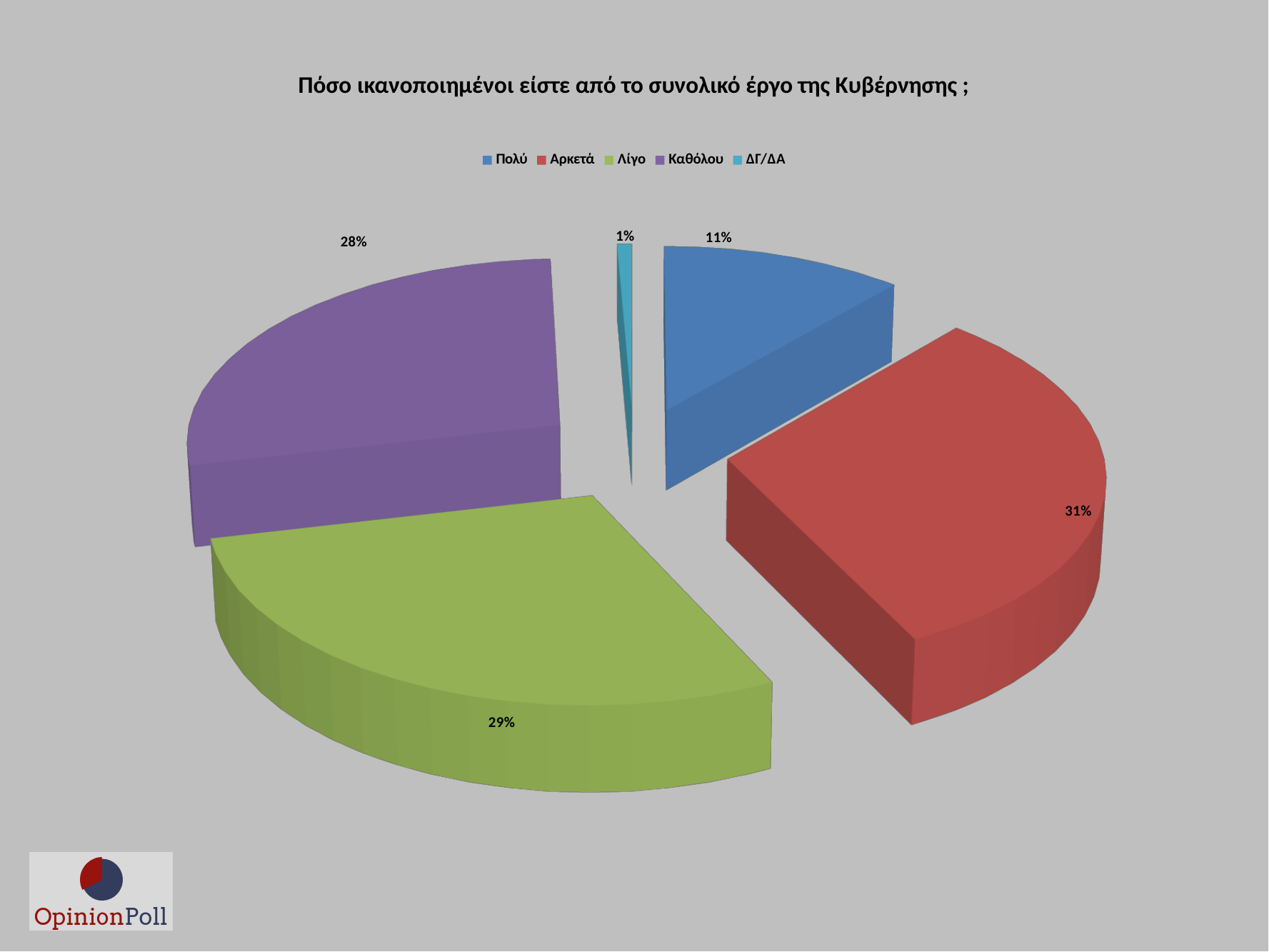
What percentage of respondents answered Αρκετά? 31% What kind of chart is shown on the slide? Pie chart Which response category has the largest share of the pie? Αρκετά What is the difference in percentage points between Λίγο and Πολύ? 18 Which is larger, the share for Καθόλου or the share for Πολύ? Καθόλου What colour is the slice for Λίγο? Green What percentage of respondents answered Πολύ? 11% What percentage of respondents answered Καθόλου? 28% Which response category has the smallest share of the pie? ΔΓ/ΔΑ What percentage of respondents answered ΔΓ/ΔΑ? 1% How many categories does the pie chart show? 5 What is the combined share of Πολύ and Αρκετά? 42%